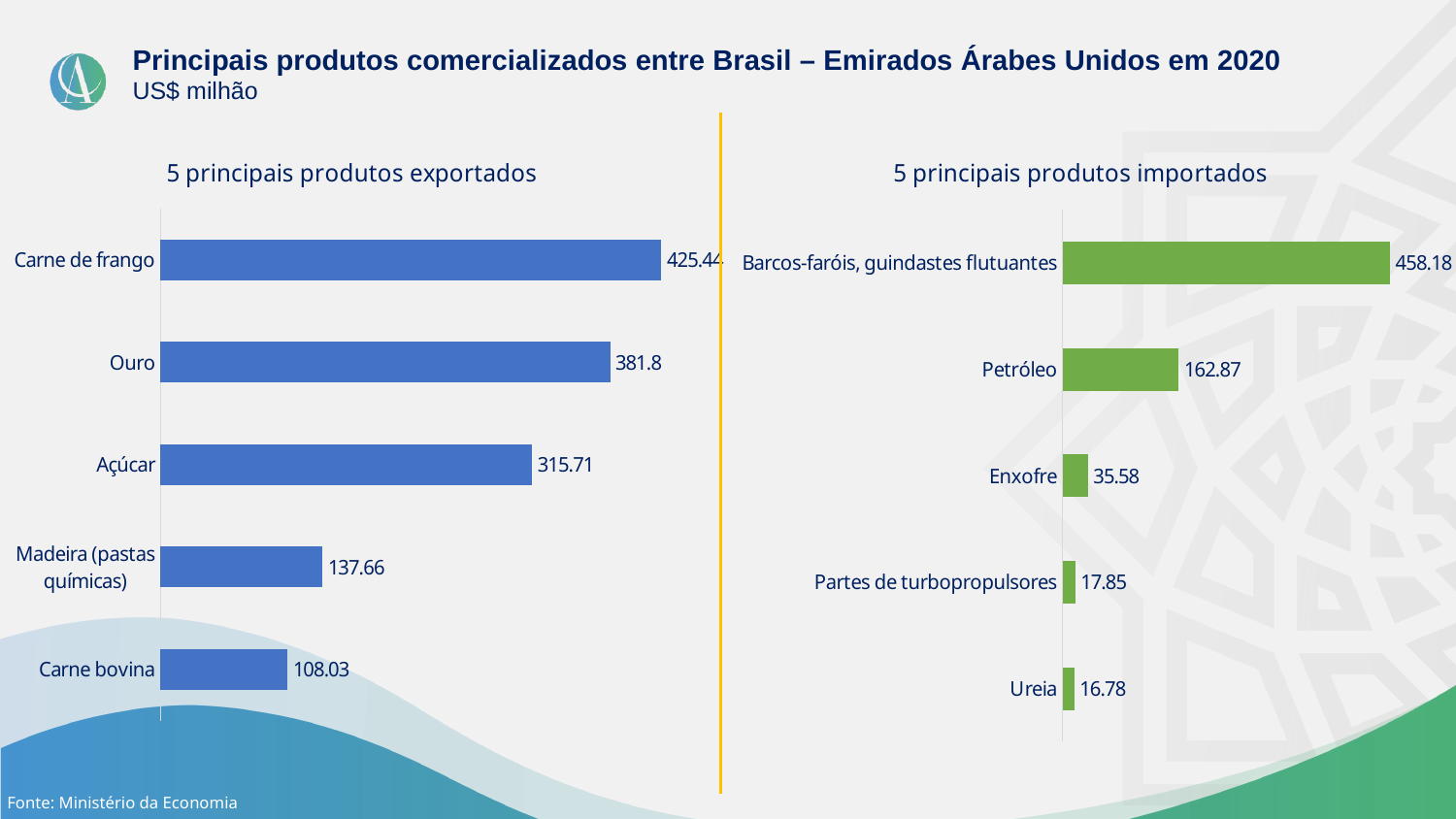
In the '5 principais produtos importados' chart, which is larger: the value for Enxofre or the value for Partes de turbopropulsores? Enxofre In the '5 principais produtos importados' chart, what is the difference between the values for Barcos-faróis, guindastes flutuantes and Petróleo? 295.31 In the '5 principais produtos importados' chart, which product has the lowest value? Ureia What unit is stated under the slide title for the values in the charts? US$ milhão In the '5 principais produtos exportados' chart, what is the difference between the values for Açúcar and Carne bovina? 207.68 What kind of chart is the '5 principais produtos exportados' chart? Bar chart In the '5 principais produtos exportados' chart, which is larger: the value for Madeira (pastas químicas) or the value for Carne bovina? Madeira (pastas químicas) In the '5 principais produtos exportados' chart, which product has the highest value? Carne de frango In the '5 principais produtos exportados' chart, what is the value for Ouro? 381.8 In the '5 principais produtos importados' chart, what is the value for Petróleo? 162.87 How many products are shown in the '5 principais produtos importados' chart? 5 In the '5 principais produtos exportados' chart, what is the value for Madeira (pastas químicas)? 137.66